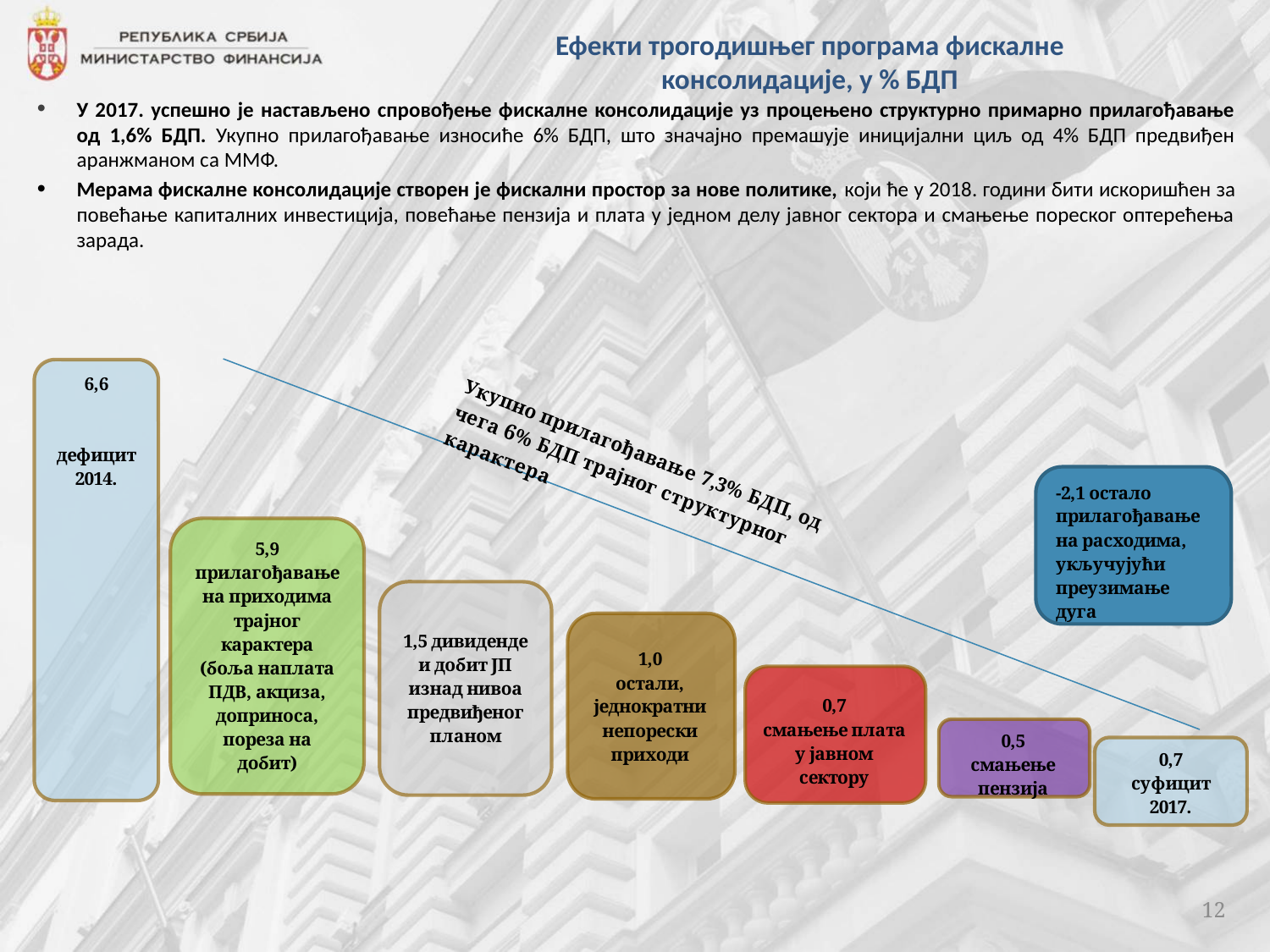
What value is shown in the box labelled 'суфицит 2017.'? 0,7 What value is shown for 'смањење пензија'? 0,5 What value is shown for 'остали, једнократни непорески приходи'? 1,0 What value is shown for 'дивиденде и добит ЈП изнад нивоа предвиђеног планом'? 1,5 What value is shown in the blue box for 'остало прилагођавање на расходима, укључујући преузимање дуга'? -2,1 Which is larger: the value for 'смањење плата у јавном сектору' or the value for 'смањење пензија'? смањење плата у јавном сектору Which box in the bottom row has the largest value? дефицит 2014. What value is shown for 'прилагођавање на приходима трајног карактера'? 5,9 What is the difference between the value for 'дефицит 2014.' and the value for 'суфицит 2017.'? 5,9 According to the diagonal text on the chart, what is the total adjustment in % of GDP? 7,3% БДП What value is shown in the box labelled 'дефицит 2014.'? 6,6 Which item in the bottom row of boxes has the smallest value? смањење пензија